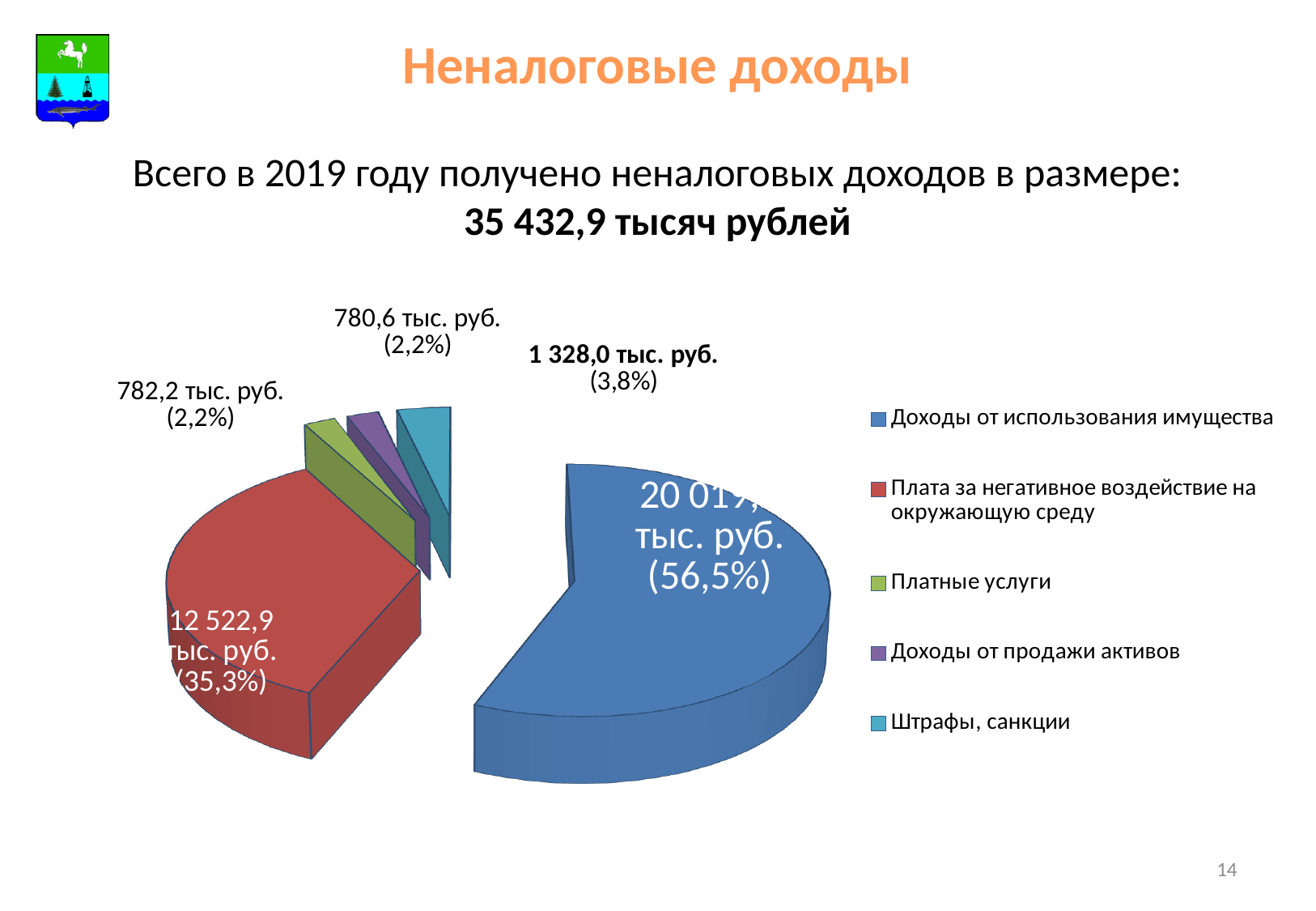
Which category has the largest slice of the pie? Доходы от использования имущества What colour is used for "Штрафы, санкции" in the pie chart? light blue What kind of chart is shown on the slide? pie chart By how many percentage points does the share of "Доходы от использования имущества" exceed the share of "Плата за негативное воздействие на окружающую среду"? 21,2 What share of the pie does "Плата за негативное воздействие на окружающую среду" represent? 35,3% What is the title of the slide containing the pie chart? Неналоговые доходы How many categories does the legend of the pie chart list? 5 Which is larger: the slice for "Плата за негативное воздействие на окружающую среду" or the slice for "Платные услуги"? Плата за негативное воздействие на окружающую среду What is the value shown for "Плата за негативное воздействие на окружающую среду"? 12 522,9 тыс. руб. What share of the pie does "Доходы от использования имущества" represent? 56,5% What is the value shown for "Штрафы, санкции"? 1 328,0 тыс. руб. What share of the pie does "Штрафы, санкции" represent? 3,8%